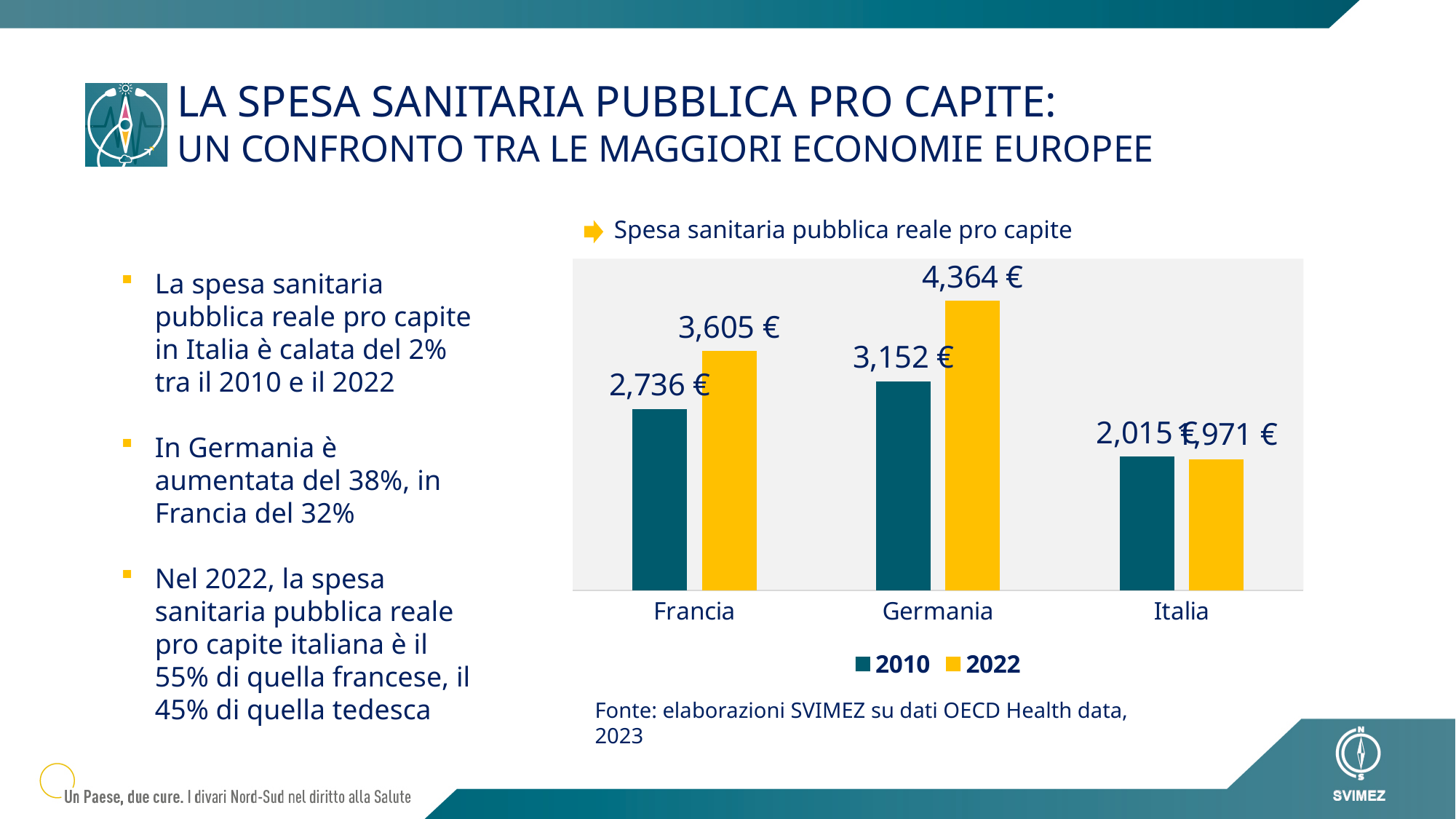
What is the value for Germania in 2010? 3,152 € Which country has the lowest value in 2010? Italia Which country has the highest value in 2022? Germania What is the difference between the 2022 values for Germania and Francia? 759 € What is the value for Francia in 2010? 2,736 € What is the value for Germania in 2022? 4,364 € Which is larger: the 2022 value for Francia or the 2010 value for Germania? Francia 2022 How many countries are shown on the x axis? 3 How many series does the legend list? 2 What type of chart is shown on the slide? Bar chart What is the difference between the 2022 and 2010 values for Germania? 1,212 € What is the value for Italia in 2022? 1,971 €